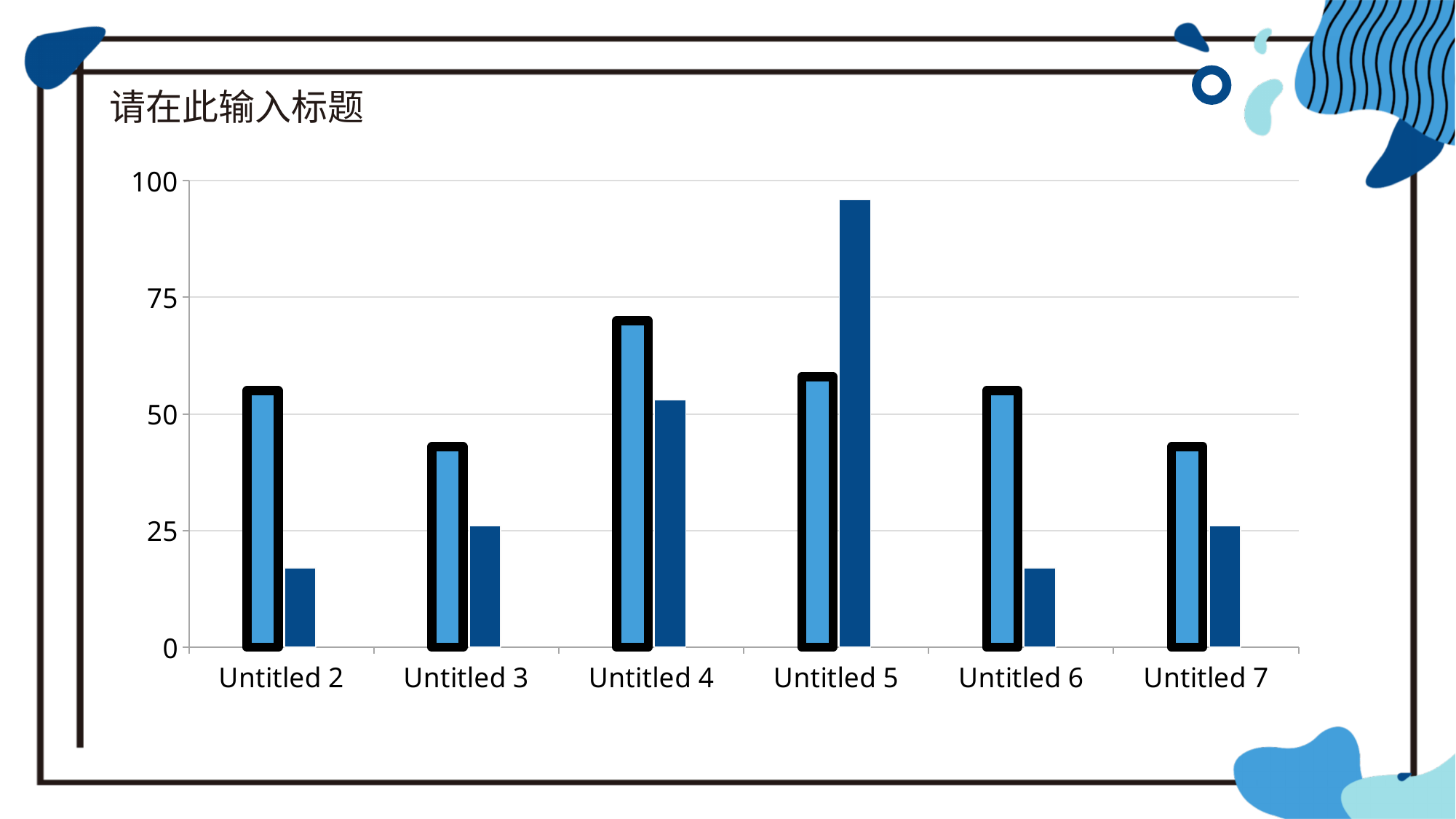
Is the light blue bar for Untitled 3 greater or less than 50? less Which is taller, the light blue bar for Untitled 4 or the light blue bar for Untitled 7? Untitled 4 Which category has the tallest bar in the chart? Untitled 5 Is the dark blue bar for Untitled 5 greater or less than 75? greater How many categories are shown on the x axis of the chart? 6 What is the highest value shown on the vertical axis of the chart? 100 For Untitled 4, which bar is taller, the light blue bar or the dark blue bar? the light blue bar Which category has the tallest light blue (outlined) bar? Untitled 4 For Untitled 5, which bar is taller, the light blue bar or the dark blue bar? the dark blue bar What kind of chart is shown on the slide? bar chart Is the light blue bar for Untitled 4 greater or less than 75? less